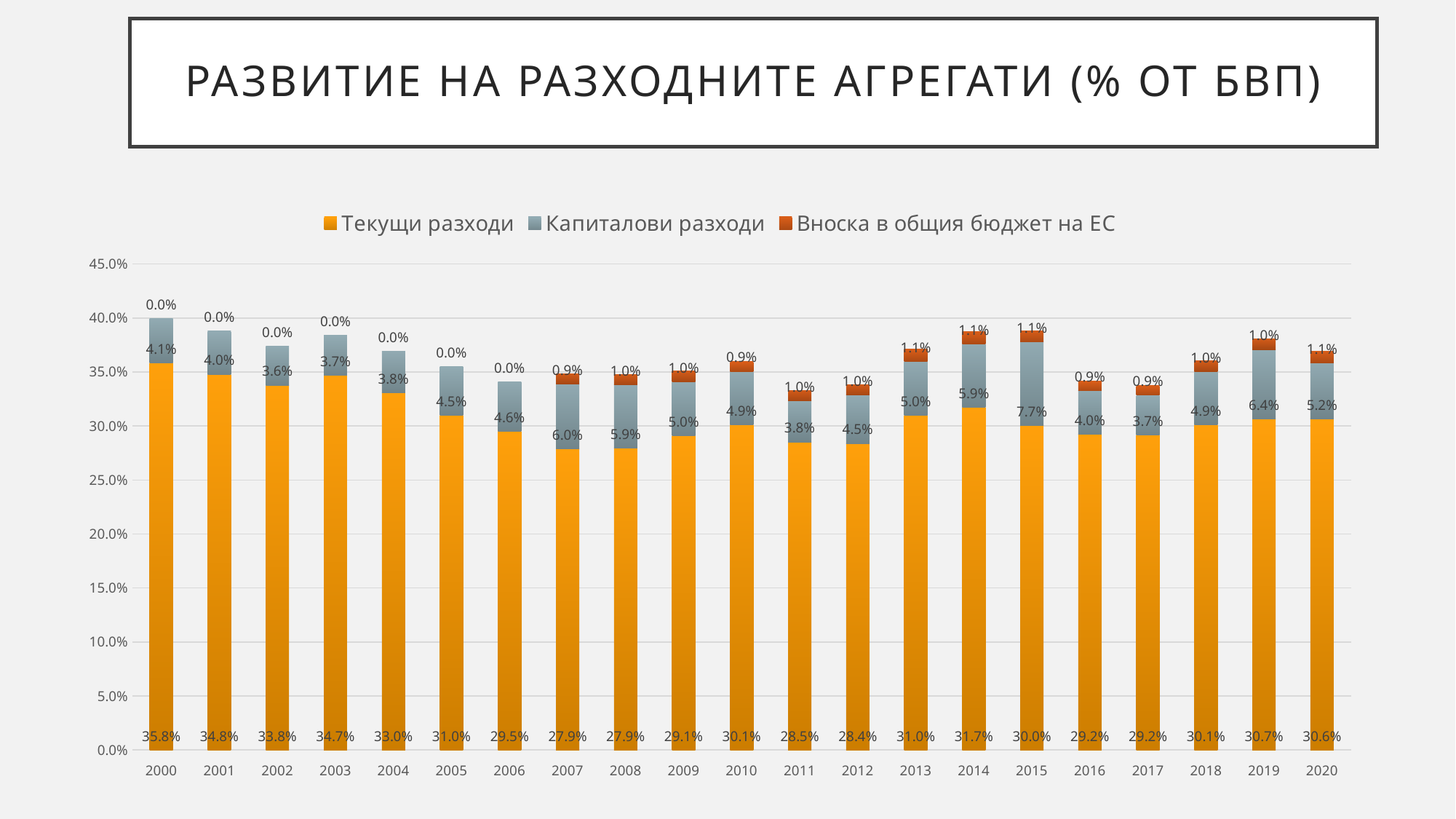
What is the difference between Текущи разходи in 2000 and in 2020? 5.2% Does Текущи разходи rise or fall from 2000 to 2007? Fall How many series does the legend list? 3 In which year is Текущи разходи highest? 2000 What is the total of the stacked bar for 2015? 38.8% How many years are shown on the x axis? 21 What is the value of Текущи разходи for 2000? 35.8% Which is larger, Капиталови разходи in 2019 or in 2007? 2019 What kind of chart is shown on the slide? Stacked bar chart In which year is Капиталови разходи highest? 2015 What is the value of Вноска в общия бюджет на ЕС for 2013? 1.1% What is the value of Капиталови разходи for 2015? 7.7%